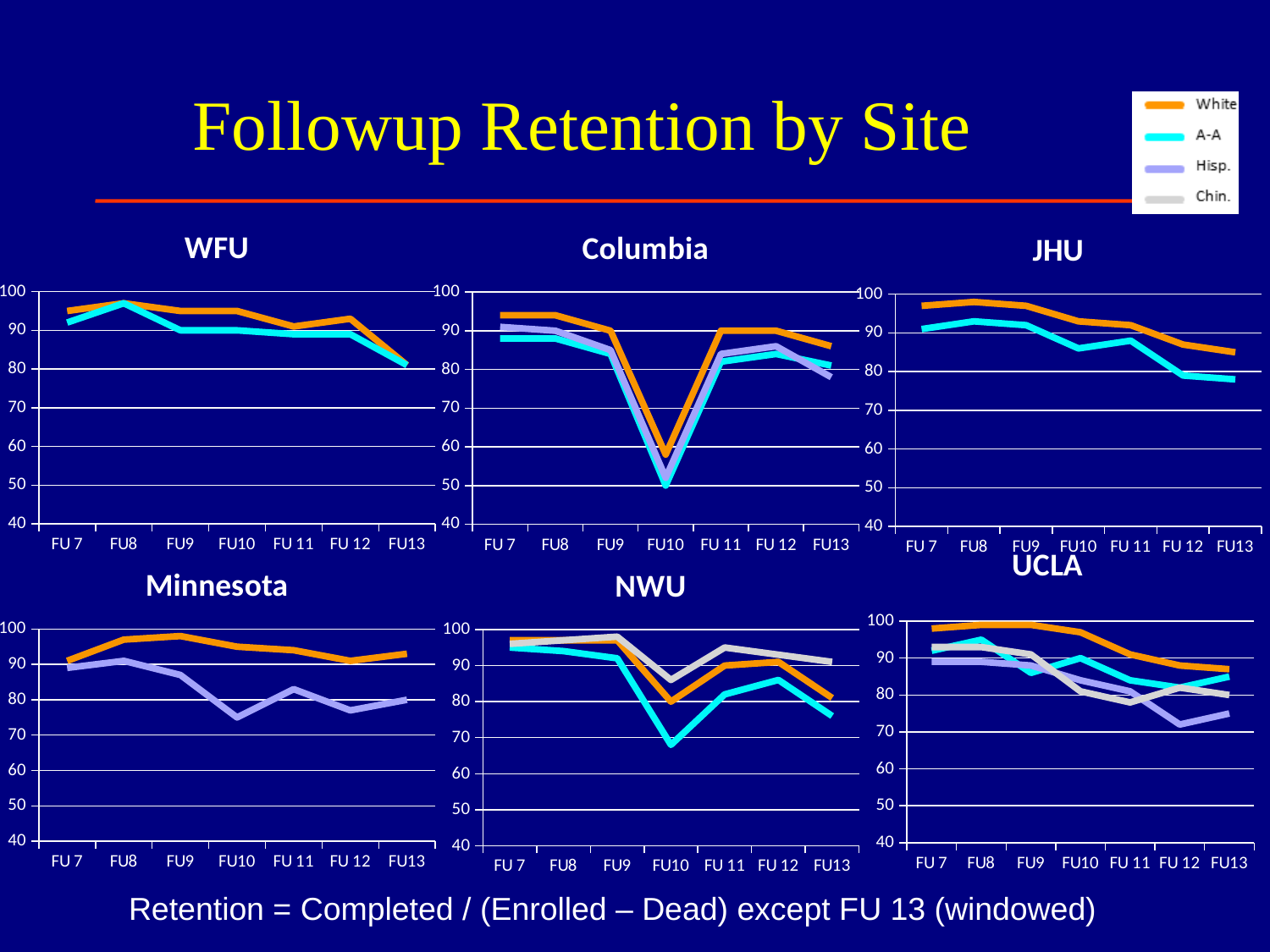
In the Columbia chart, which series has the lowest value at FU10? A-A In the Columbia chart, is the A-A value at FU10 greater or less than 60? less In the JHU chart, is the White value at FU 7 greater or less than 90? greater What kind of chart is used for the WFU panel? line chart In the WFU chart, does the A-A line rise or fall from FU8 to FU13? fall In the Minnesota chart, which series is higher at FU10, White or Hisp.? White How many follow-up points are plotted along the x axis of the Columbia chart? 7 In the Columbia chart, at which follow-up is the A-A value lowest? FU10 How many series does the legend in the top right list? 4 In the Minnesota chart, is the Hisp. value at FU10 greater or less than 80? less